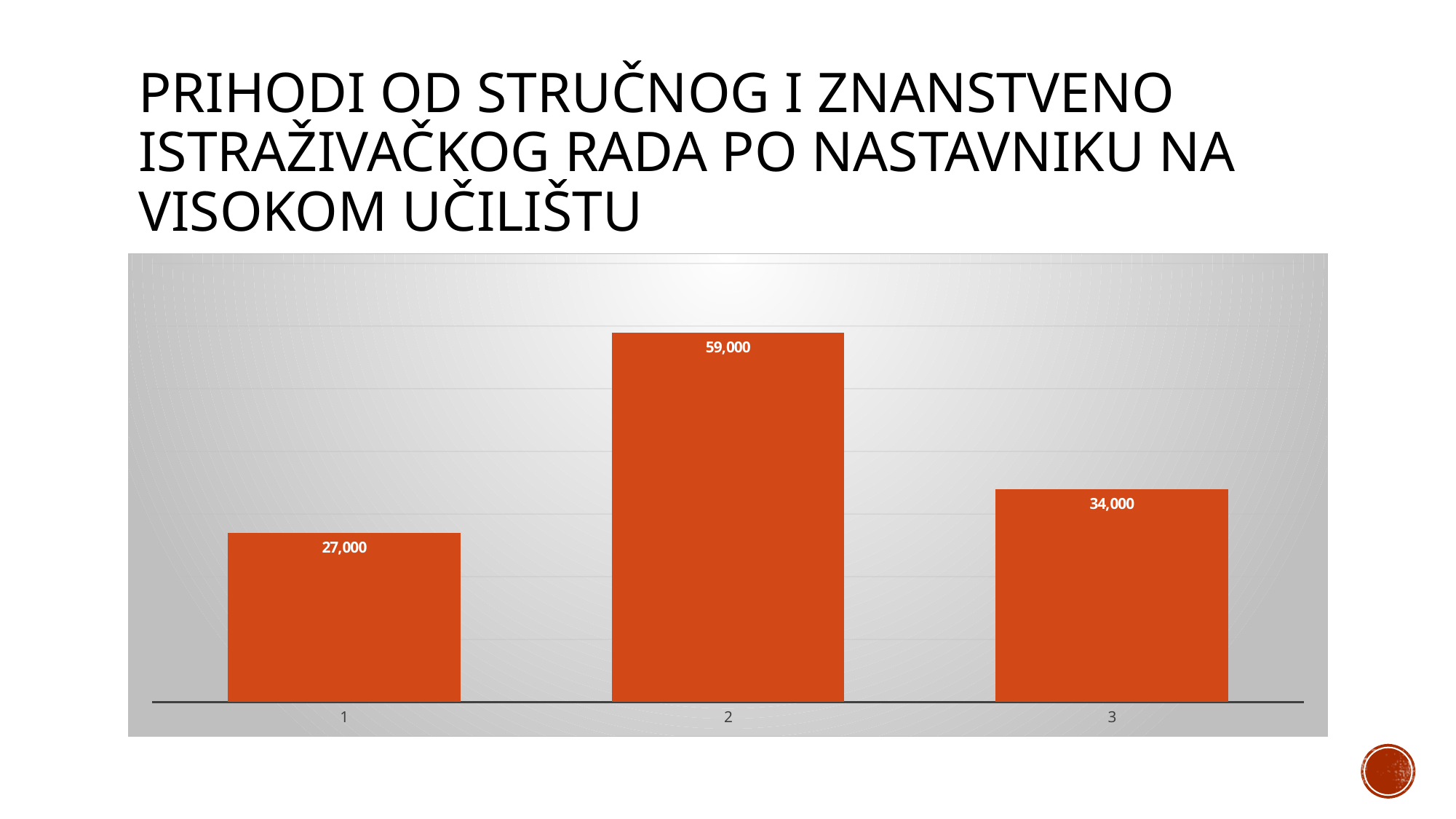
What colour are the bars in the chart? orange How many bars are shown in the chart? 3 Which category has the lowest value? 1 What is the total of the three values shown in the chart? 120,000 What is the value for category 2? 59,000 What is the value for category 3? 34,000 What kind of chart is shown on the slide? bar chart Which is larger, the value for category 2 or category 3? 2 What is the value for category 1? 27,000 What is the difference between the values for category 3 and category 1? 7,000 Which category has the highest value? 2 What is the difference between the values for category 2 and category 1? 32,000